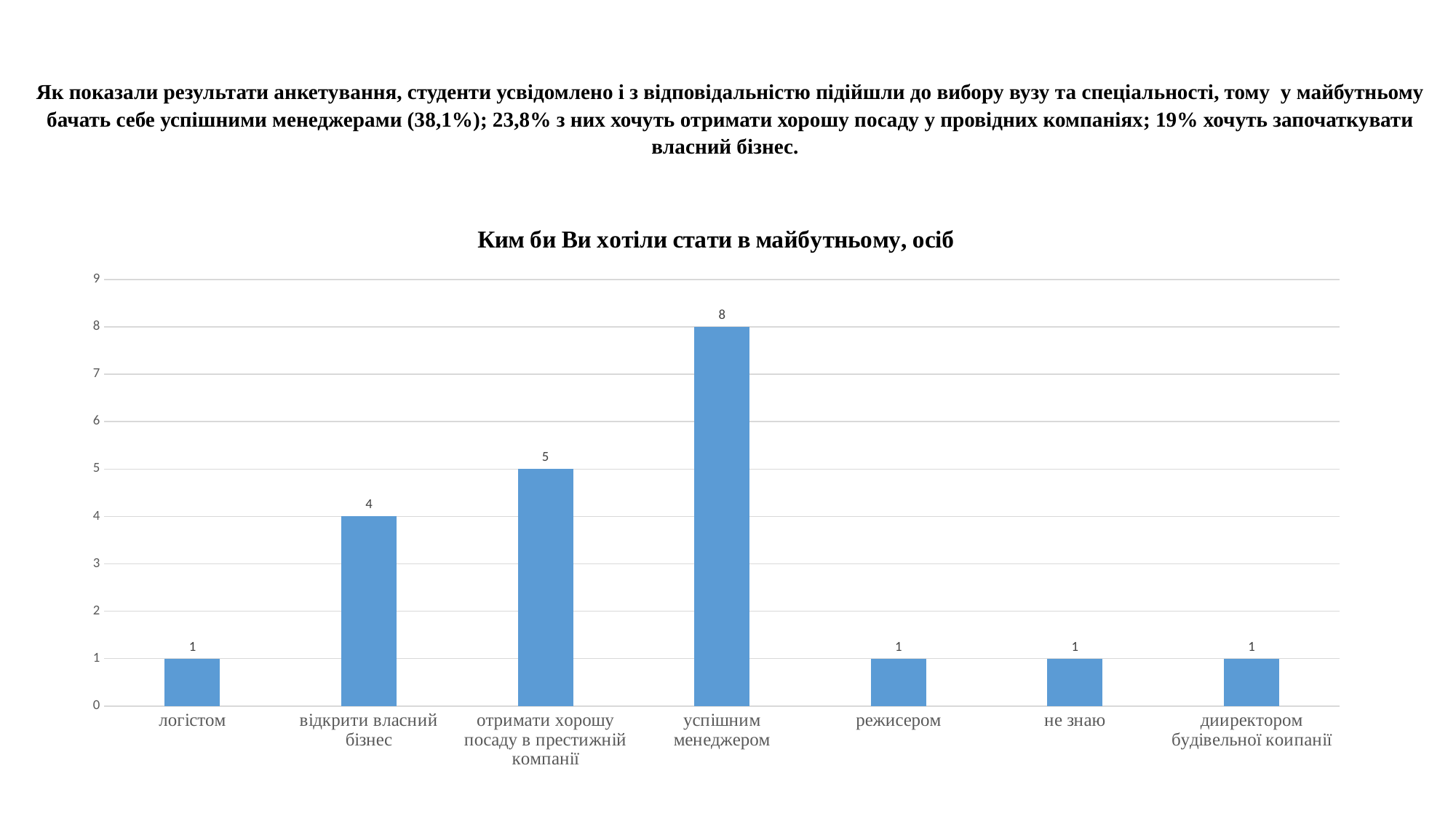
What is the difference between the values for "успішним менеджером" and "отримати хорошу посаду в престижній компанії"? 3 Which category has the highest value? успішним менеджером What kind of chart is shown on the slide? bar chart What is the value for "отримати хорошу посаду в престижній компанії"? 5 How many categories are shown on the x axis? 7 What is the title of the chart? Ким би Ви хотіли стати в майбутньому, осіб What is the difference between the values for "отримати хорошу посаду в престижній компанії" and "відкрити власний бізнес"? 1 What is the value for "відкрити власний бізнес"? 4 What is the value for "успішним менеджером"? 8 Is the value for "успішним менеджером" greater or less than 5? greater What is the value for "не знаю"? 1 Which is larger, the value for "відкрити власний бізнес" or the value for "режисером"? відкрити власний бізнес